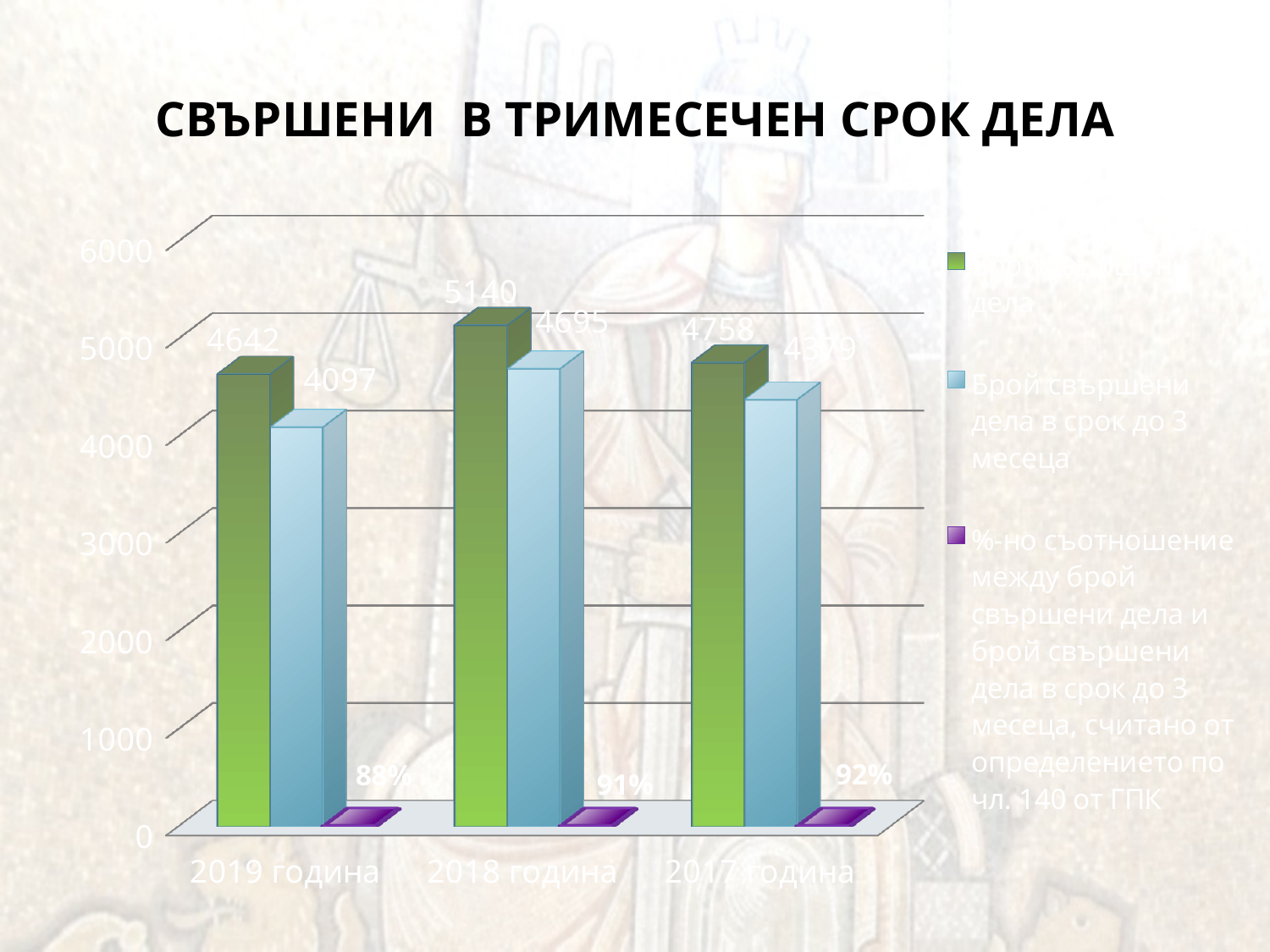
What percentage is shown for 2017 година? 92% What is the value of the green bar for 2017 година? 4758 How many series does the legend list? 3 Which year has the lowest value for the blue bars (Брой свършени дела в срок до 3 месеца)? 2019 година What is the value of the blue bar (Брой свършени дела в срок до 3 месеца) for 2019 година? 4097 What kind of chart is shown on the slide? Bar chart Which year has the highest value for the green bars (Брой свършени дела)? 2018 година Which is larger: the blue bar for 2017 година or the blue bar for 2019 година? 2017 година What is the difference between the green bar and the blue bar for 2018 година? 445 What is the title of the chart? СВЪРШЕНИ В ТРИМЕСЕЧЕН СРОК ДЕЛА How many year categories are shown on the x axis? 3 What is the value of the green bar (Брой свършени дела) for 2018 година? 5140